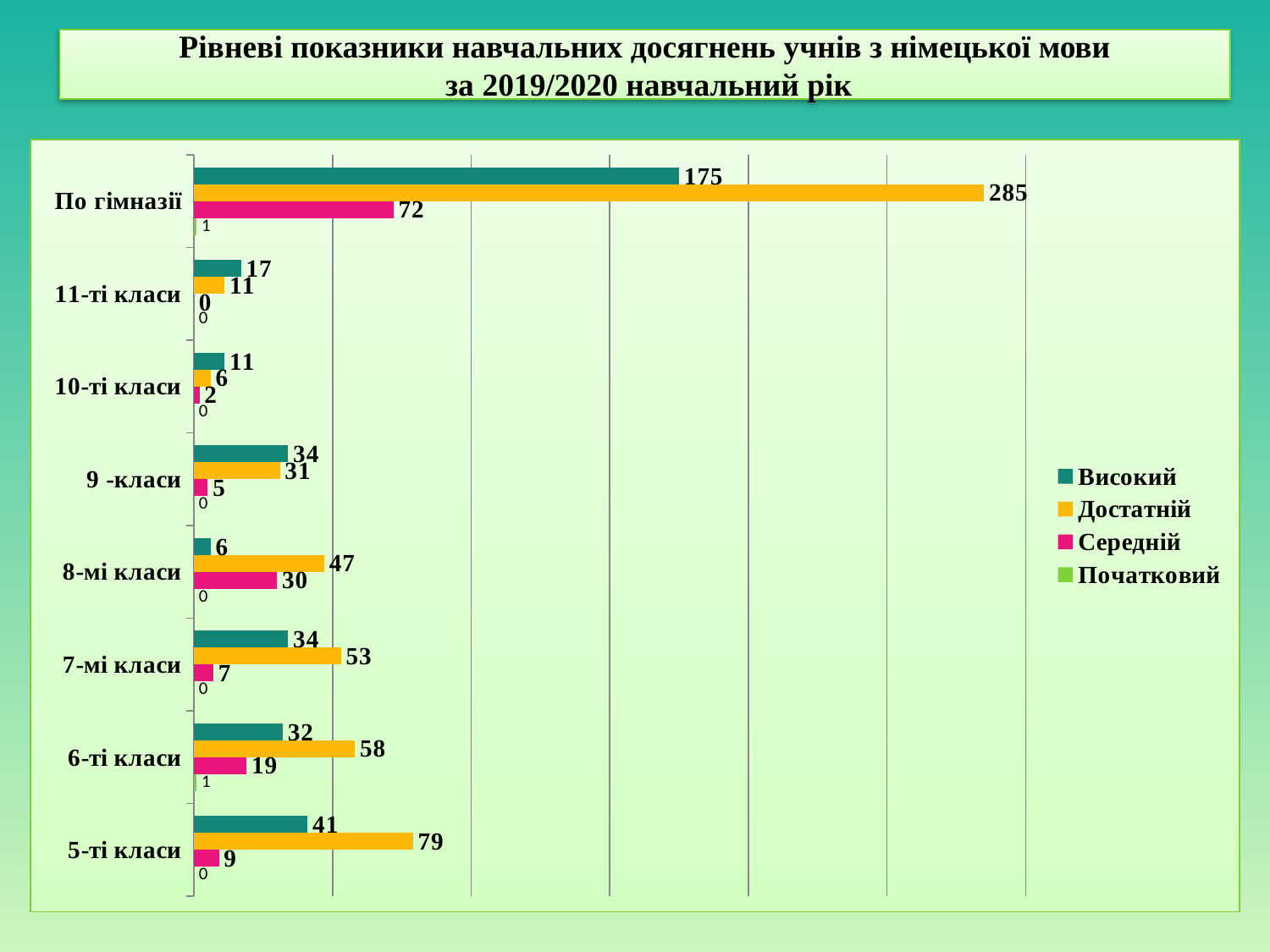
Which is larger for 7-мі класи: Високий or Достатній? Достатній Among the class categories (excluding По гімназії), which has the highest Достатній value? 5-ті класи Which series is shown in pink in the legend? Середній What kind of chart is shown on the slide? Bar chart How many categories are shown on the y axis? 8 What is the value of Високий for 5-ті класи? 41 What is the value of Середній for 8-мі класи? 30 How many series does the legend list? 4 What is the difference between the Достатній and Високий values for По гімназії? 110 What is the value of Достатній for 6-ті класи? 58 What is the value of Достатній for По гімназії? 285 Which category has the lowest Високий value? 8-мі класи